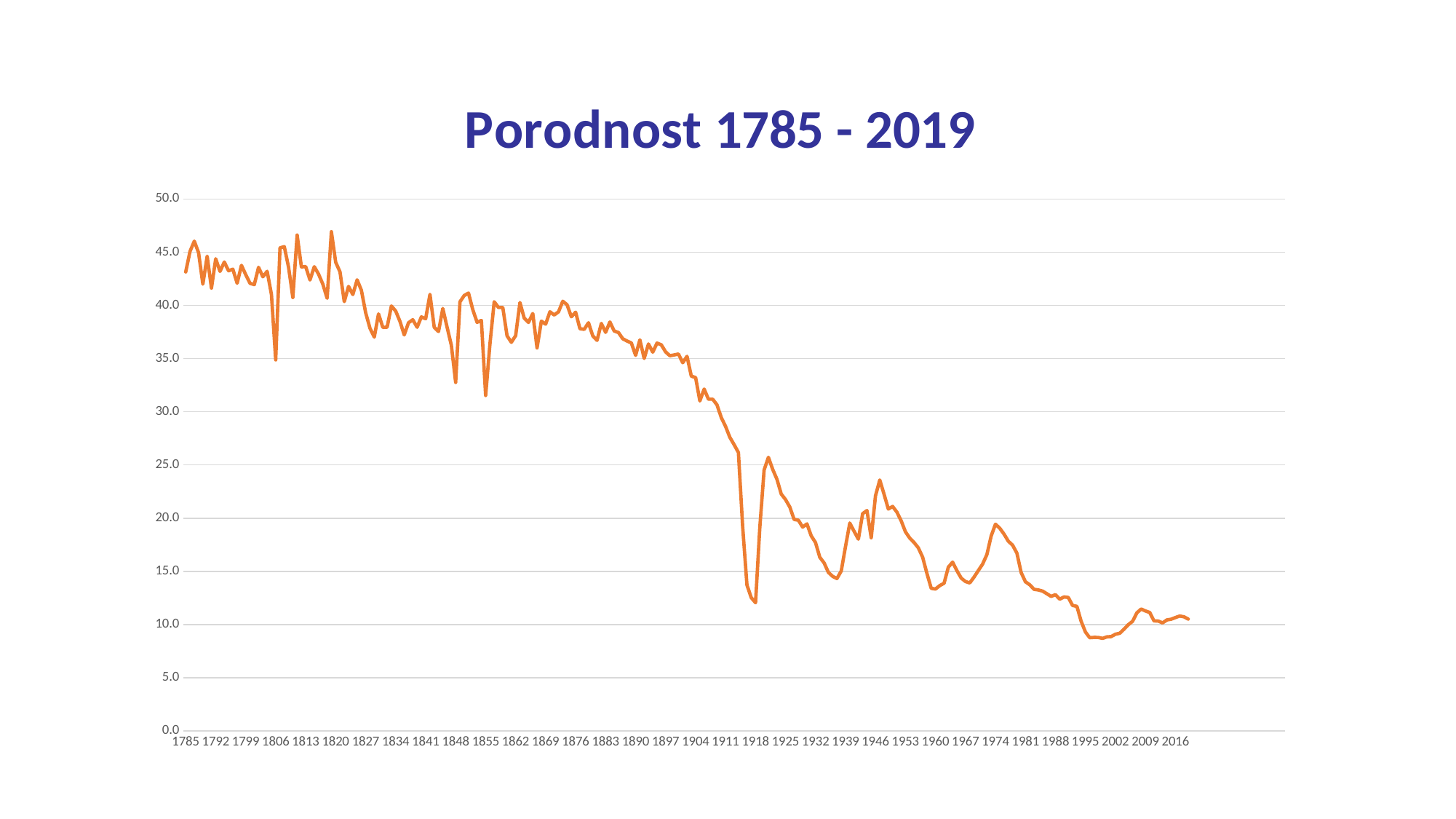
What colour is the line in the chart? orange Is the value for 1911 greater or less than 30.0? less Which year has the larger value, 1785 or 2016? 1785 Is the value for 1918 greater or less than 15.0? less Is the value for 1876 greater or less than 35.0? greater Overall, do the values rise or fall from 1785 to 2019? fall What is the title of the chart? Porodnost 1785 - 2019 What kind of chart is shown on the slide? line chart